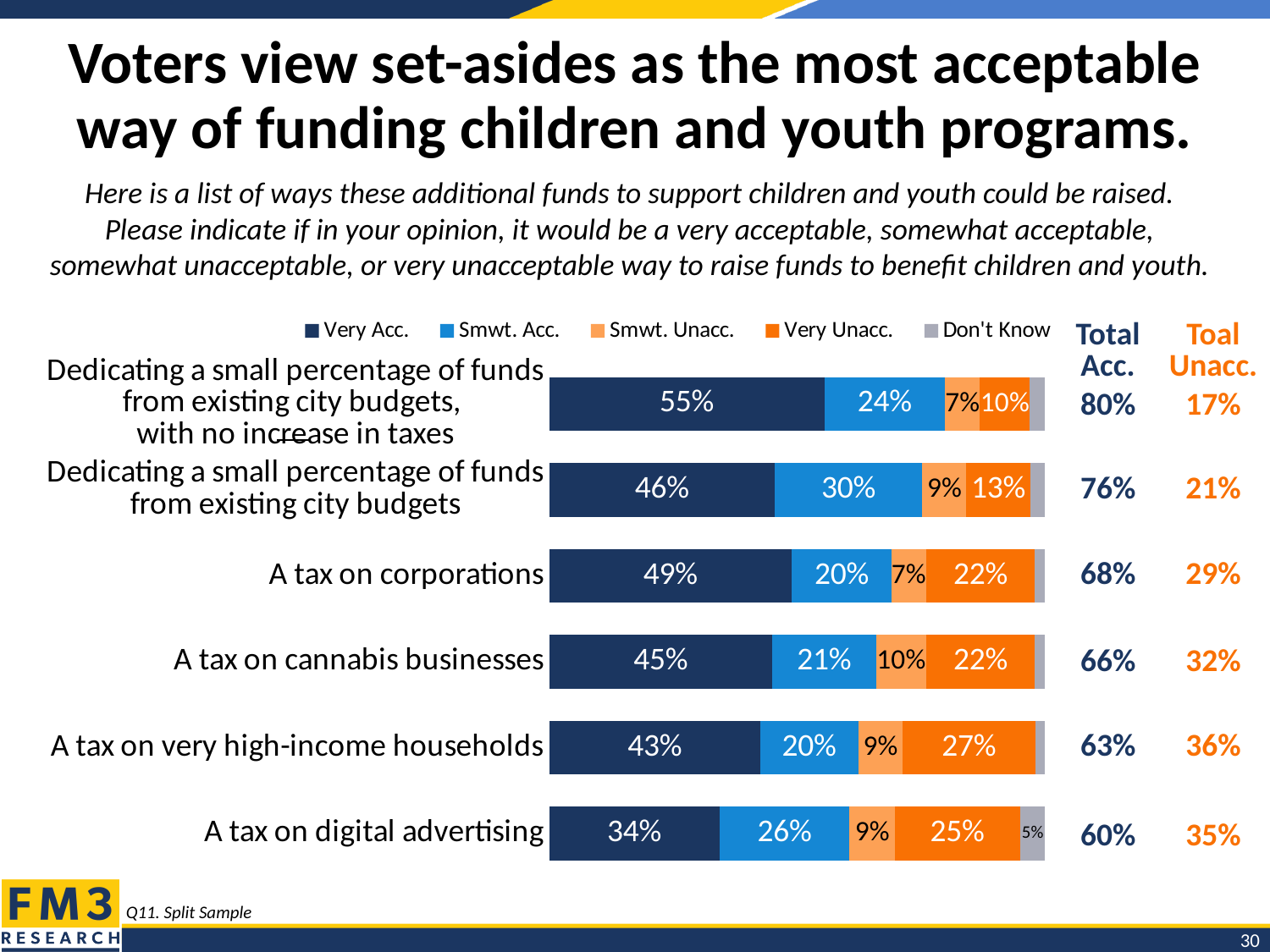
Which has a larger 'Very Unacc.' value: a tax on very high-income households or a tax on digital advertising? A tax on very high-income households How many funding options are shown in the chart? 6 What is the 'Smwt. Unacc.' value for a tax on cannabis businesses? 10% What percentage of voters said a tax on corporations is a very acceptable way to raise funds? 49% How many series does the legend list? 5 What is the 'Don't Know' value shown for a tax on digital advertising? 5% What is the 'Smwt. Acc.' value for a tax on digital advertising? 26% Which funding option has the lowest 'Very Acc.' percentage? A tax on digital advertising What is the 'Very Unacc.' value for a tax on very high-income households? 27% What type of chart is shown on the slide? Stacked bar chart What is the difference between the 'Very Acc.' values for a tax on corporations and a tax on cannabis businesses? 4% Which funding option has the highest 'Very Acc.' percentage? Dedicating a small percentage of funds from existing city budgets, with no increase in taxes